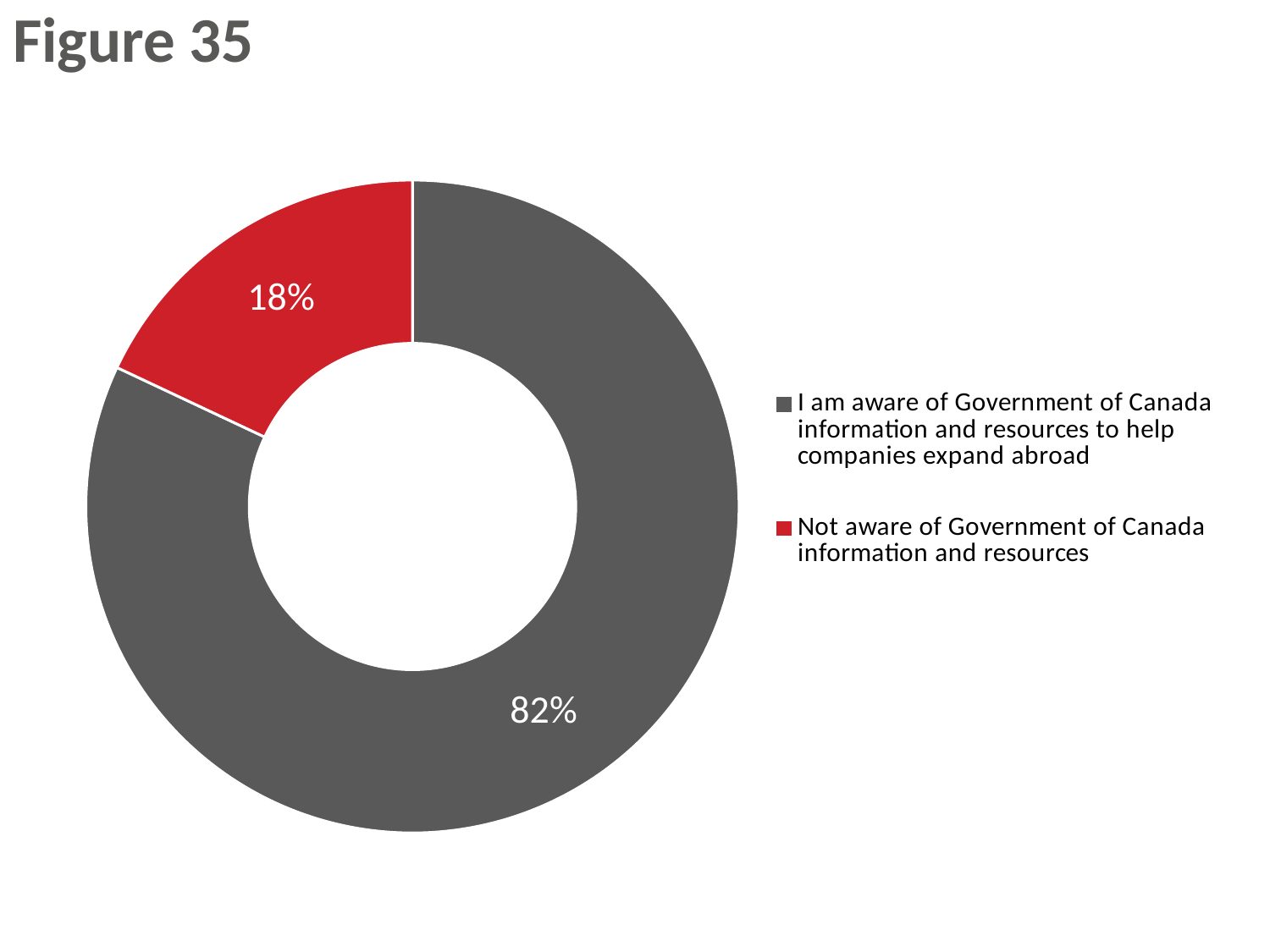
What is the title of the figure on the slide? Figure 35 Which is larger: the share of respondents aware of Government of Canada resources or the share not aware? Aware What colour is the slice for respondents not aware of Government of Canada information and resources? Red What percentage of respondents are not aware of Government of Canada information and resources? 18% How many categories are shown in the chart? 2 What share of the chart does the 'Not aware of Government of Canada information and resources' slice represent? 18% What is the difference in percentage points between those aware and those not aware of Government of Canada information and resources? 64 What kind of chart is shown on the slide? Doughnut (pie) chart What percentage of respondents are aware of Government of Canada information and resources to help companies expand abroad? 82% Which category has the largest share of the chart? I am aware of Government of Canada information and resources to help companies expand abroad Which category has the smallest share of the chart? Not aware of Government of Canada information and resources